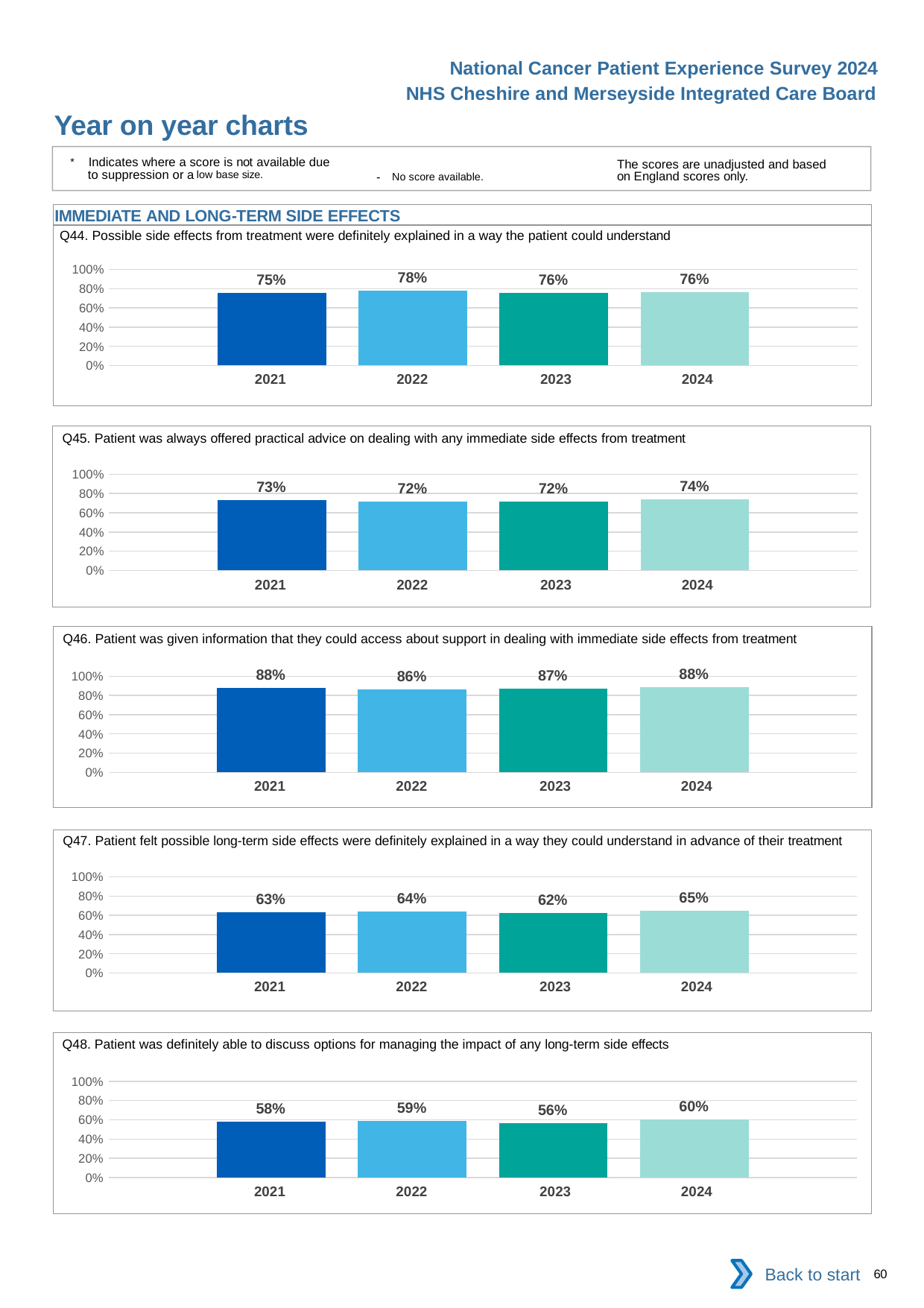
In the Q47 chart, which is larger, the value for 2023 or the value for 2024? 2024 In the Q44 chart, which year has the highest value? 2022 How many years are shown on the x axis of the Q48 chart? 4 In the Q48 chart, what is the value for 2021? 58% In the Q46 chart, which year has the lowest value? 2022 In the Q48 chart, which year has the lowest value? 2023 In the Q44 chart, what is the value for 2022? 78% In the Q47 chart, what is the difference between the 2024 value and the 2023 value? 3% What type of chart is the Q44 chart? Bar chart In the Q45 chart, what is the difference between the 2024 value and the 2022 value? 2% In the Q45 chart, what is the value for 2024? 74% In the Q46 chart, what is the value for 2023? 87%